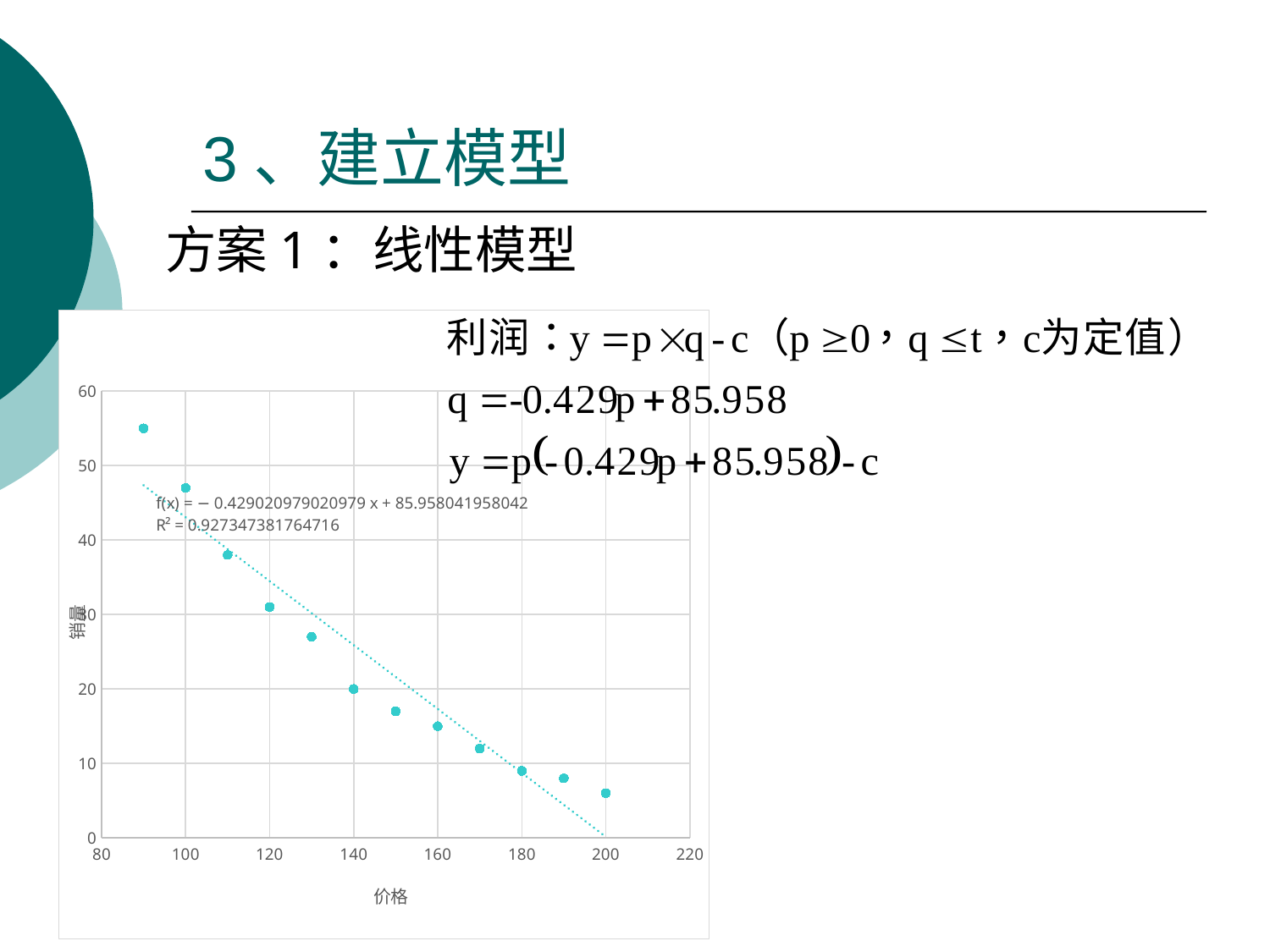
What is the R² value printed on the chart for the trendline? 0.927347381764716 Is the 销量 value at 价格 200 greater or less than 10? less Do the plotted values rise or fall as 价格 increases along the x axis? fall Is the 销量 value at 价格 160 greater or less than 20? less At which 价格 value is 销量 lowest? 200 What is the title of the x axis of the chart? 价格 Is the 销量 value at 价格 90 greater or less than 50? greater How many data points are plotted in the chart? 12 At which 价格 value is 销量 highest? 90 Which has the larger 销量: 价格 100 or 价格 190? 价格 100 What kind of chart is shown on the slide? scatter chart